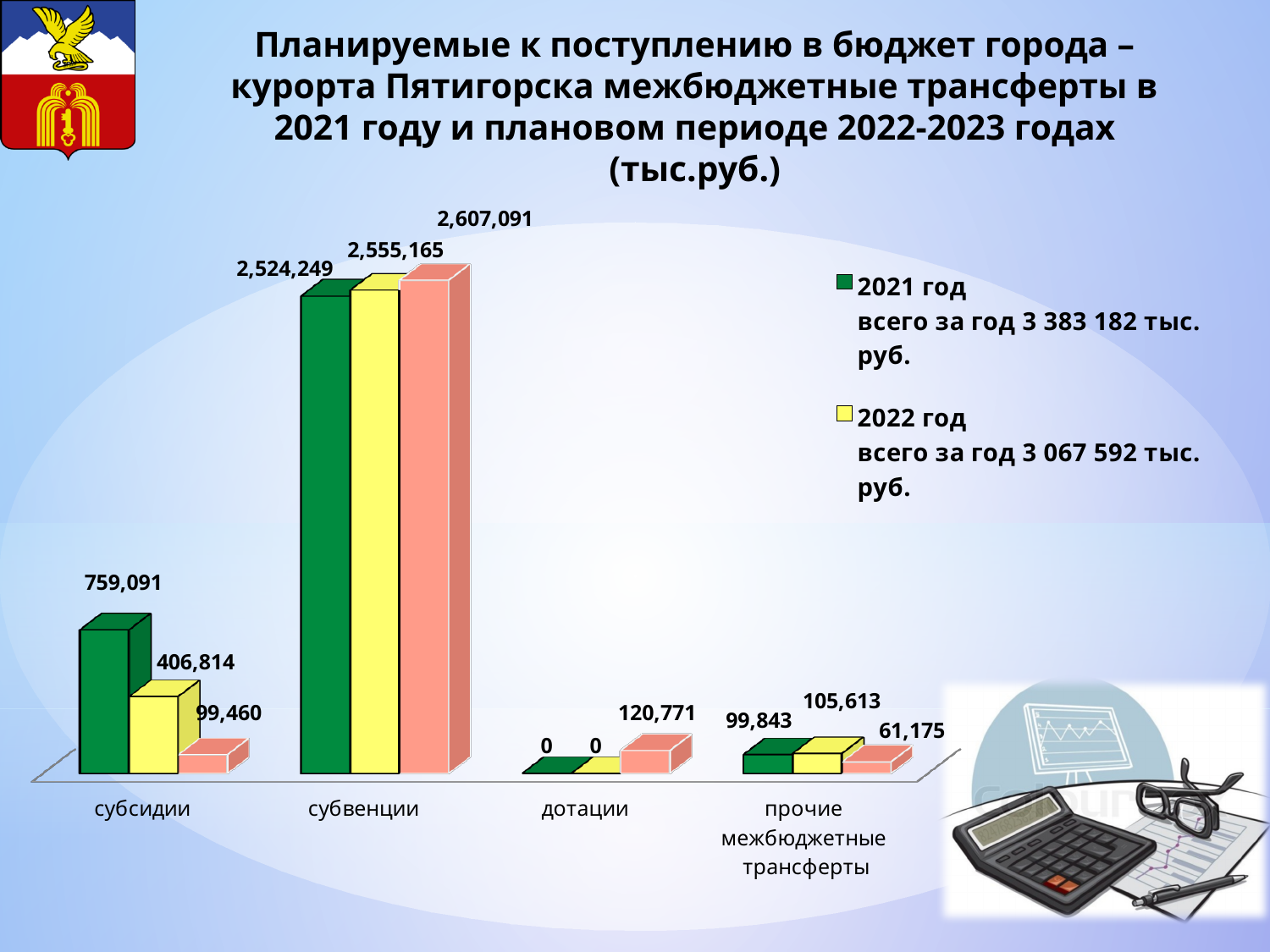
Which category has the highest value in the 2021 год series? субвенции What is the difference between the 2021 год and 2022 год values for субсидии? 352,277 What is the difference between the 2022 год and 2021 год values for субвенции? 30,916 How many categories are shown on the x axis? 4 According to the legend, what is the total for the year 2021 год? 3 383 182 тыс. руб. What is the value of the pink bar for дотации? 120,771 What is the value for субсидии in the 2021 год series? 759,091 What is the value for дотации in the 2021 год series? 0 Which category has the lowest value in the 2022 год series? дотации What kind of chart is shown on the slide? bar chart For прочие межбюджетные трансферты, which is larger: the 2021 год value or the 2022 год value? 2022 год What is the value for субвенции in the 2022 год series? 2,555,165